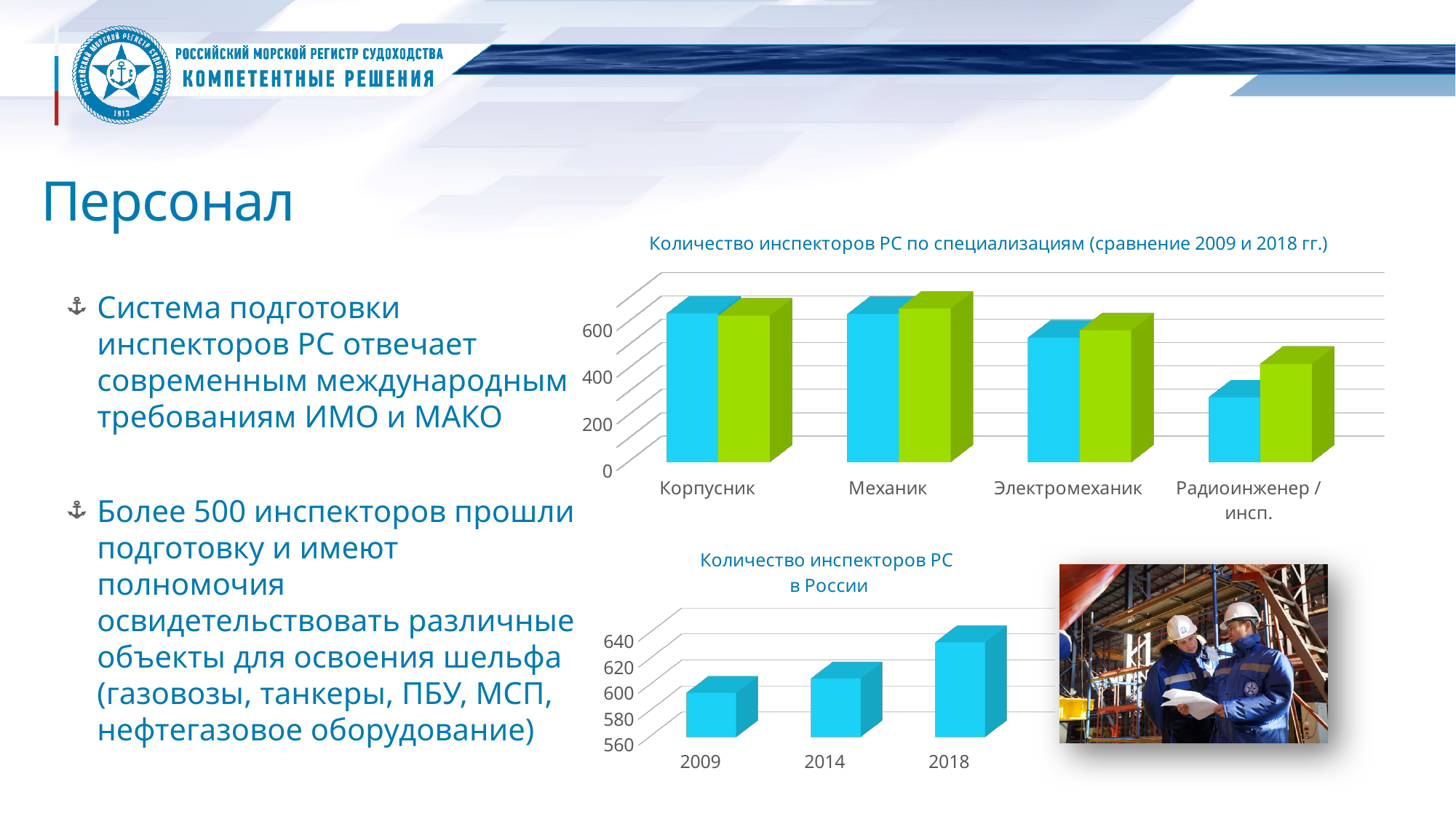
On the top chart, 'Количество инспекторов РС по специализациям', which is larger: the blue bar for Корпусник or the blue bar for Радиоинженер / инсп.? Корпусник On the bottom chart, 'Количество инспекторов РС в России', is the value for 2009 greater or less than 620? less What kind of chart is the top chart, 'Количество инспекторов РС по специализациям'? bar chart On the top chart, 'Количество инспекторов РС по специализациям', which category has the lowest values? Радиоинженер / инсп. On the bottom chart, 'Количество инспекторов РС в России', do the values rise or fall from 2009 to 2018? rise On the top chart, 'Количество инспекторов РС по специализациям', is the blue bar for Радиоинженер / инсп. greater or less than 400? less How many years are shown on the bottom chart, 'Количество инспекторов РС в России'? 3 On the top chart, 'Количество инспекторов РС по специализациям', is the blue bar for Корпусник greater or less than 600? greater On the bottom chart, 'Количество инспекторов РС в России', which year has the highest value? 2018 What is the title of the top chart on the slide? Количество инспекторов РС по специализациям (сравнение 2009 и 2018 гг.) How many specialization categories are shown on the top chart, 'Количество инспекторов РС по специализациям'? 4